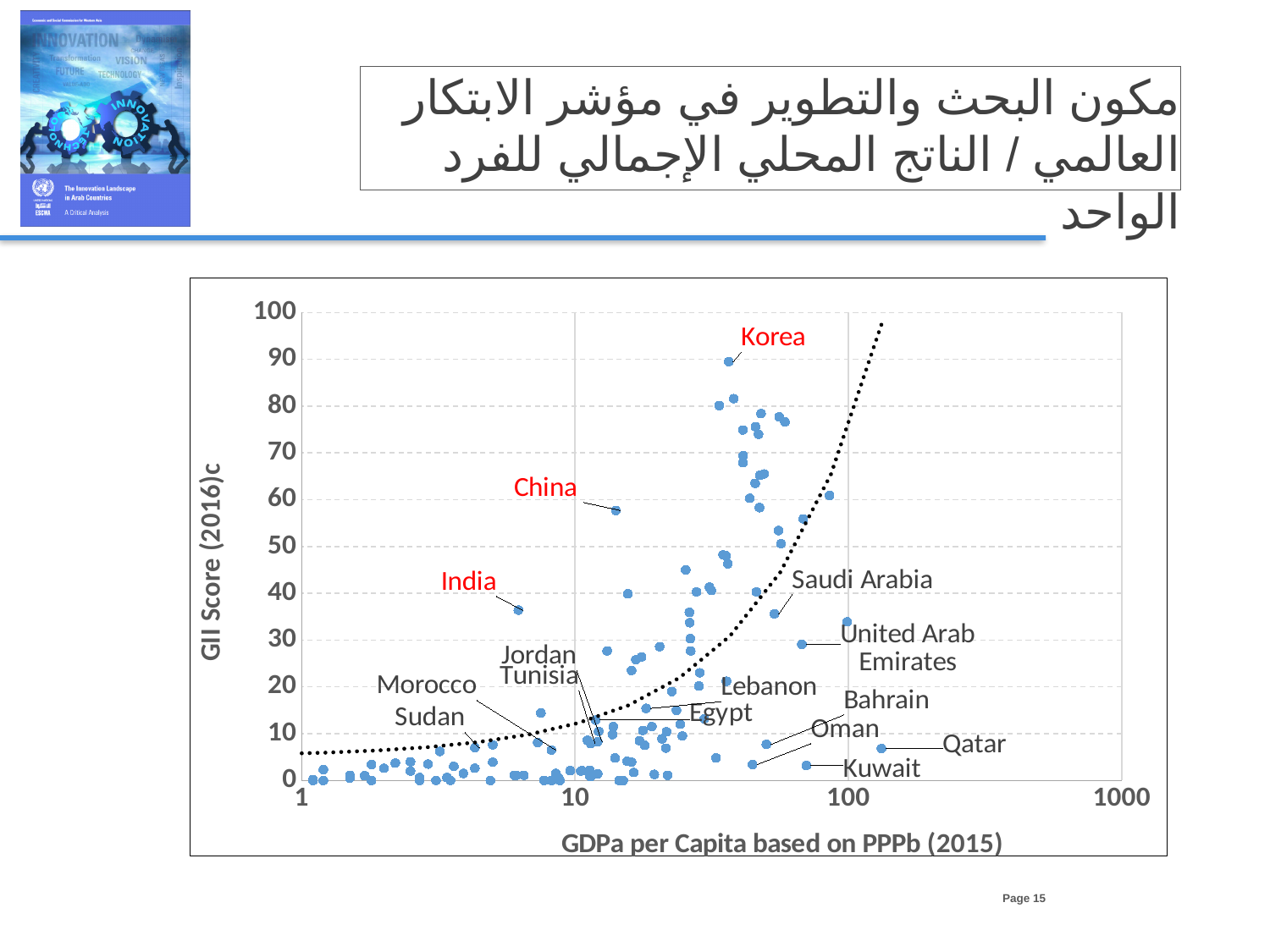
What is the title of the y-axis of the chart? GII Score (2016)c What is the title of the x-axis of the chart? GDPa per Capita based on PPPb (2015) Which has a higher GII Score, Saudi Arabia or Kuwait? Saudi Arabia Is the GII Score for Sudan greater or less than 10? less Is the GII Score for Qatar greater or less than 10? less Is the GII Score for Korea greater or less than 80? greater Among the labelled countries, which has the highest GII Score? Korea Which has a higher GII Score, Korea or China? Korea What kind of chart is shown on the slide? Scatter plot